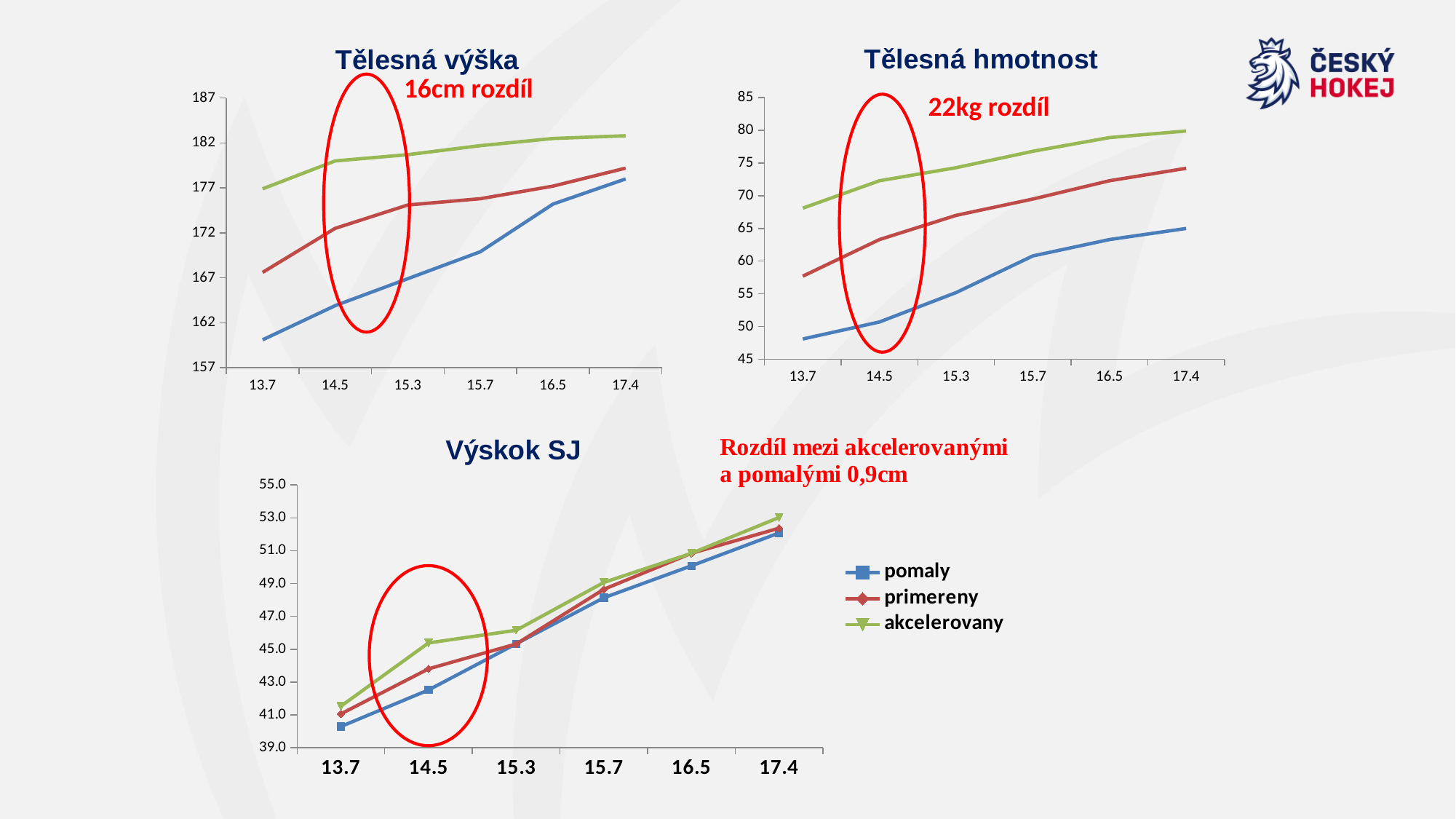
In the 'Výskok SJ' chart, is the value for 'akcelerovany' at 14.5 greater or less than 45.0? greater How many x-axis categories does the 'Tělesná hmotnost' chart have? 6 What kind of chart is the 'Tělesná výška' chart? line chart In the 'Výskok SJ' chart, which is larger at 13.7: 'akcelerovany' or 'pomaly'? akcelerovany In the 'Tělesná výška' chart, is the value of the blue line at 17.4 greater or less than 177? greater In the 'Tělesná hmotnost' chart, is the value of the blue line at 13.7 greater or less than 50? less In the 'Výskok SJ' chart, do the values for 'pomaly' rise or fall from 13.7 to 17.4? rise In the 'Výskok SJ' chart, which series has the lowest value at 14.5? pomaly How many series does the legend of the 'Výskok SJ' chart list? 3 What is the title of the chart in the top right of the slide? Tělesná hmotnost